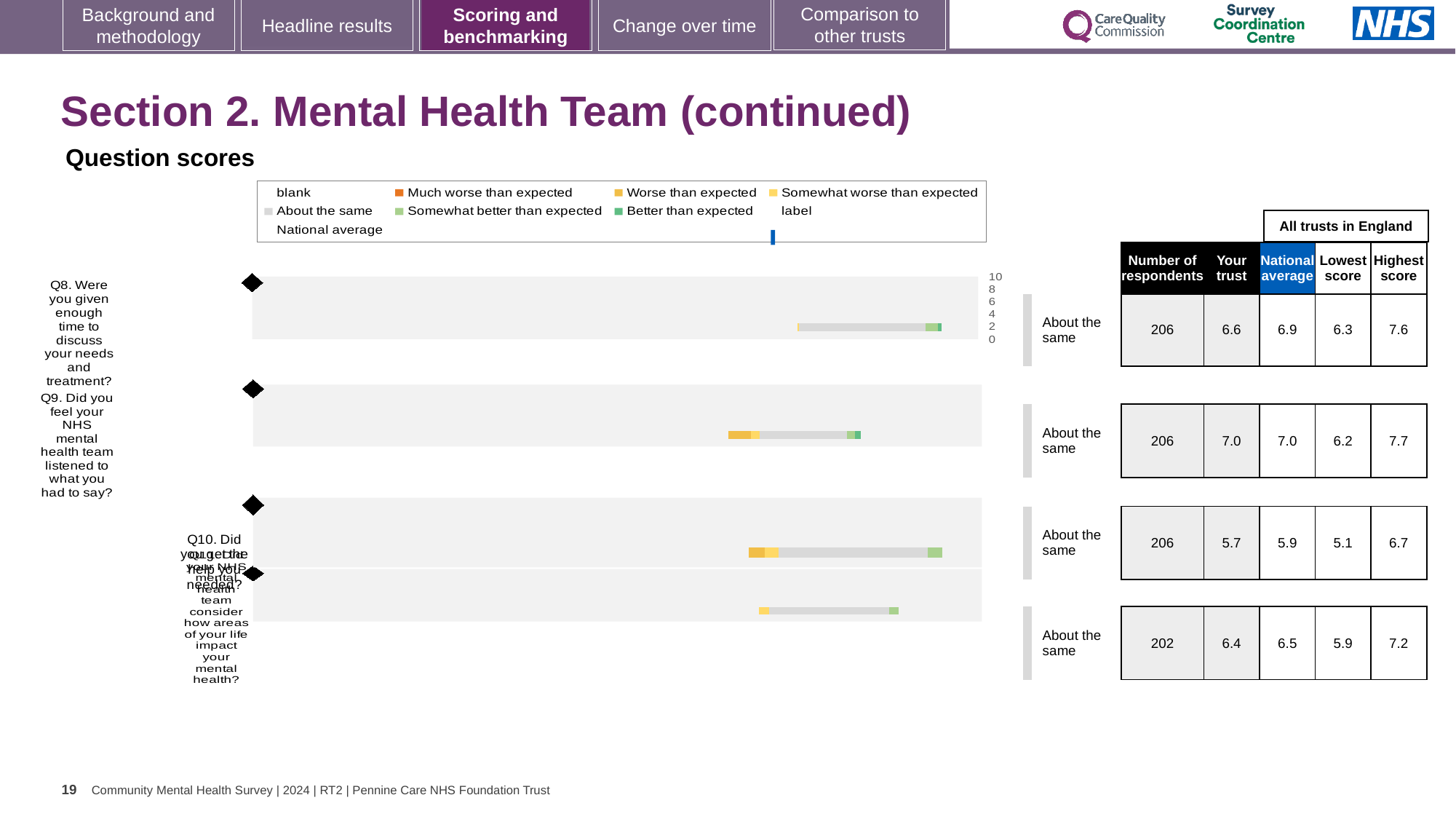
In the table beside the chart, what is the number of respondents for the fourth question (Q11)? 202 In the table beside the chart, is the 'Your trust' score for Q10 larger or smaller than the national average for Q10? smaller How many questions (bars) are plotted in the Question scores chart? 4 In the table beside the chart, what is the difference between the highest score and the lowest score for Q8? 1.3 According to the table beside the chart, which question has the lowest 'Your trust' score? Q10 In the table beside the chart, what is the highest score for Q10 (Did you get the help you needed)? 6.7 What kind of chart is shown under 'Question scores'? bar chart According to the table beside the chart, which question has the highest 'Your trust' score? Q9 In the table beside the chart, what is the 'Your trust' score for Q8 (Were you given enough time to discuss your needs and treatment)? 6.6 How many entries does the legend of the Question scores chart list? 9 In the table beside the chart, what is the national average for Q9 (Did you feel your NHS mental health team listened to what you had to say)? 7.0 What benchmark category is shown next to each bar in the Question scores chart? About the same